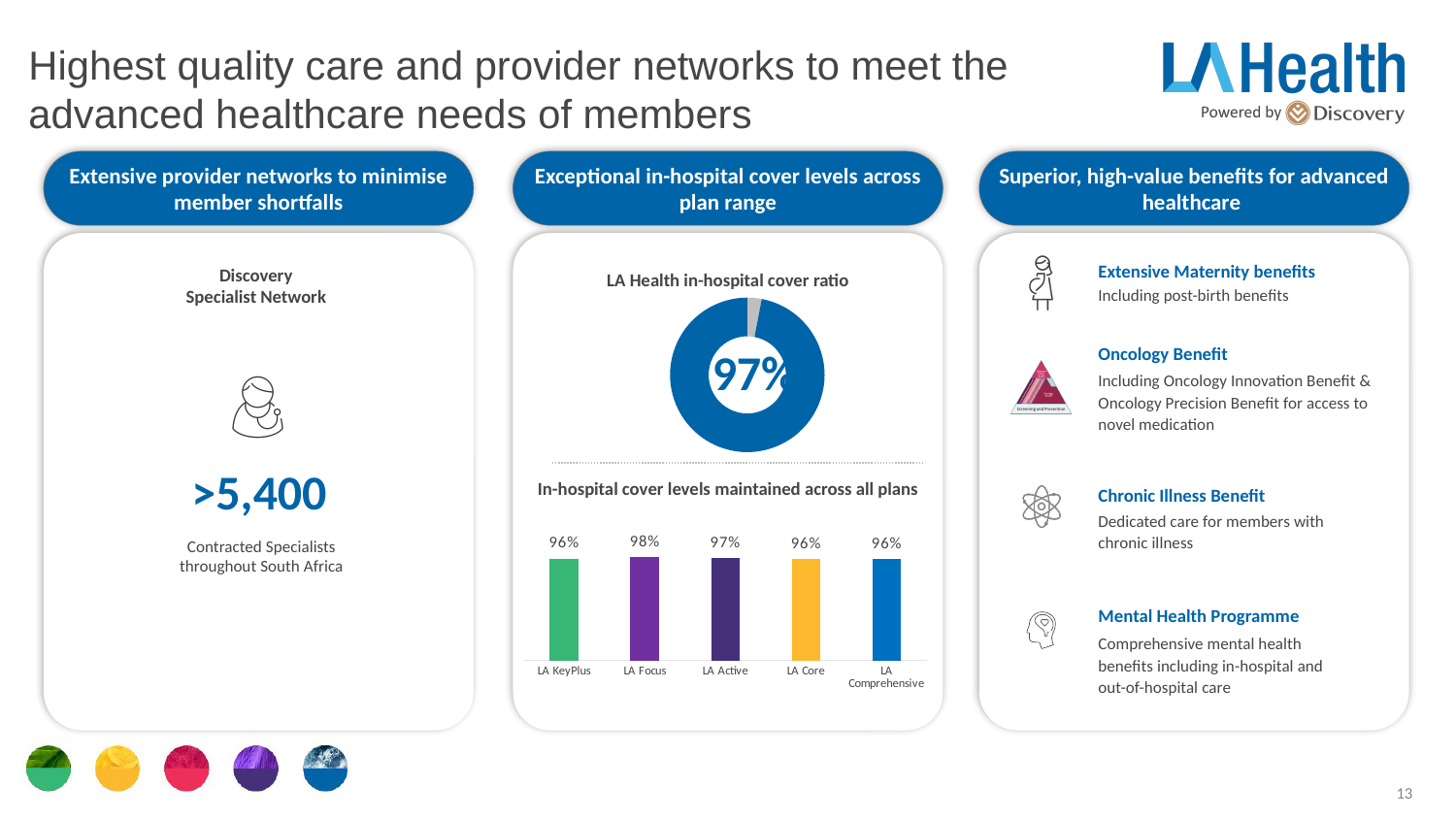
In the bar chart titled 'In-hospital cover levels maintained across all plans', which is larger, LA Active or LA Core? LA Active In the bar chart titled 'In-hospital cover levels maintained across all plans', what is the label of the first bar on the left? LA KeyPlus What value is shown in the centre of the donut chart titled 'LA Health in-hospital cover ratio'? 97% In the bar chart titled 'In-hospital cover levels maintained across all plans', what is the value for LA Comprehensive? 96% In the bar chart titled 'In-hospital cover levels maintained across all plans', what is the value for LA Focus? 98% In the bar chart titled 'In-hospital cover levels maintained across all plans', what is the value for LA Active? 97% In the bar chart titled 'In-hospital cover levels maintained across all plans', which plan has the highest value? LA Focus In the bar chart titled 'In-hospital cover levels maintained across all plans', what is the difference between LA Focus and LA KeyPlus? 2% What kind of chart is 'In-hospital cover levels maintained across all plans'? Bar chart What kind of chart is 'LA Health in-hospital cover ratio'? Donut chart In the bar chart titled 'In-hospital cover levels maintained across all plans', what colour is the LA Core bar? Yellow How many plans are shown in the bar chart titled 'In-hospital cover levels maintained across all plans'? 5